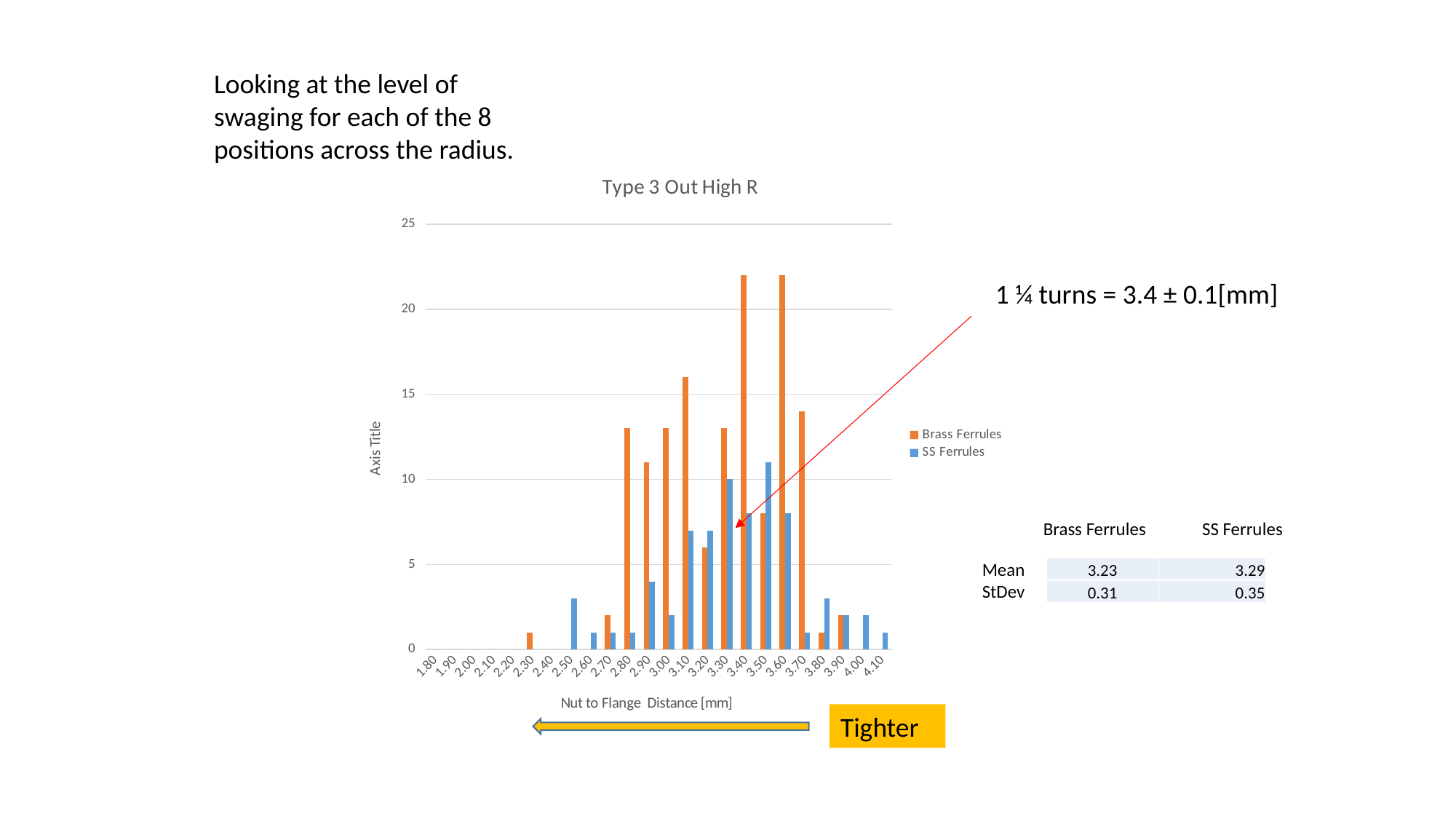
Is the Brass Ferrules value at 2.80 greater or less than 10? greater Is the Brass Ferrules value at 3.60 greater or less than 20? greater Is the SS Ferrules value at 2.50 greater or less than 5? less How many categories are shown along the x axis of the chart? 24 At 2.50, which series has the larger value, Brass Ferrules or SS Ferrules? SS Ferrules How many series does the chart legend list? 2 At 3.40, which series has the larger value, Brass Ferrules or SS Ferrules? Brass Ferrules What is the title of the chart? Type 3 Out High R Which colour represents Brass Ferrules in the chart? orange What kind of chart is shown on the slide? bar chart